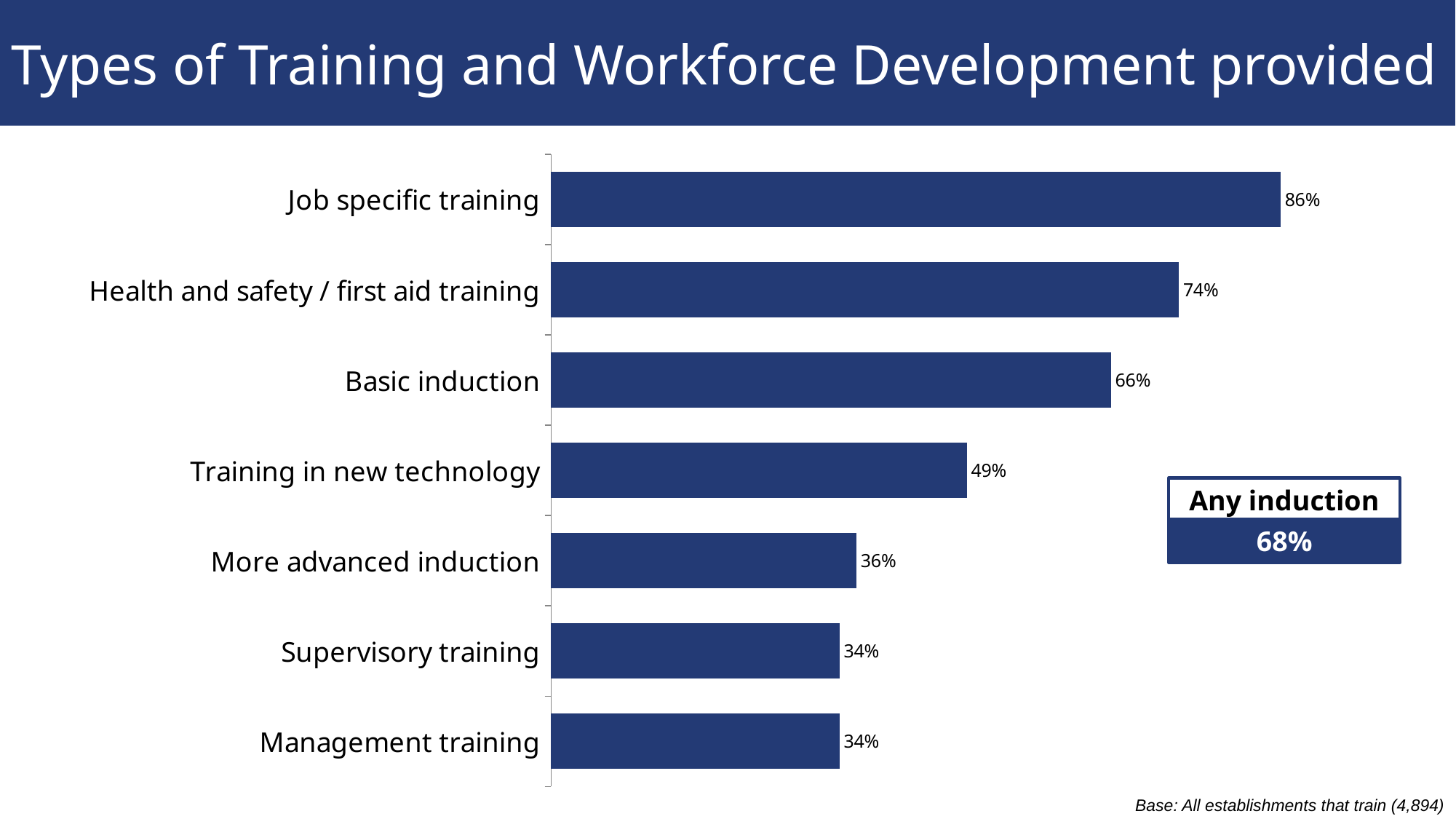
What percentage is shown in the 'Any induction' box? 68% What is the value shown for Training in new technology? 49% What is the value shown for Health and safety / first aid training? 74% What kind of chart is shown on the slide? Bar chart Which type of training has the highest percentage? Job specific training What is the title of the slide? Types of Training and Workforce Development provided How many types of training are shown in the chart? 7 What percentage of establishments provide job specific training? 86% What is the difference between the values for Basic induction and More advanced induction? 30% What is the value shown for More advanced induction? 36% What is the difference between the values for Job specific training and Basic induction? 20% Which is larger, the value for Basic induction or the value for Training in new technology? Basic induction